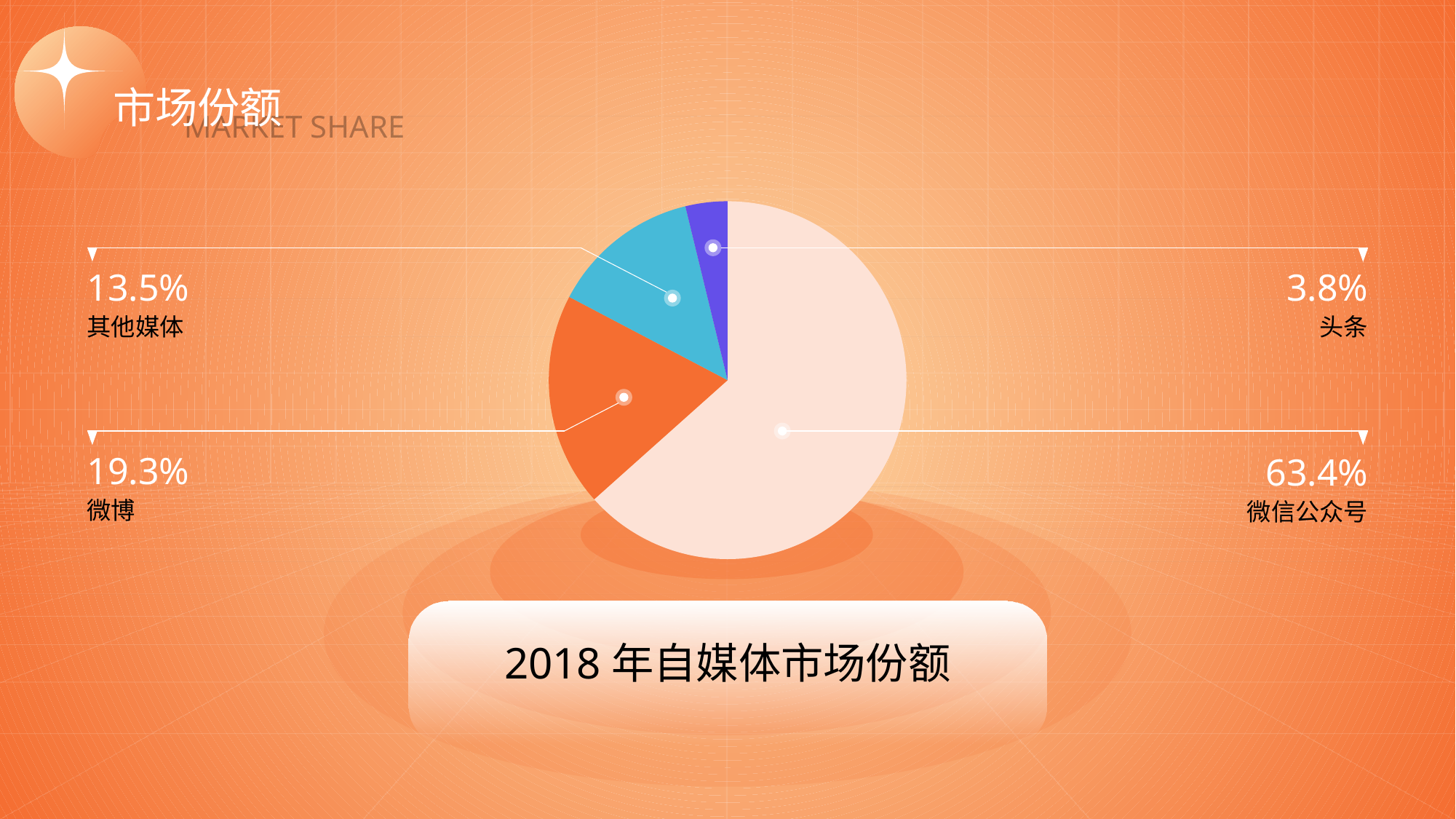
What is the difference between the shares of 微博 and 其他媒体? 5.8% What is the market share of 其他媒体? 13.5% What is the market share of 微信公众号? 63.4% What is the title shown below the pie chart? 2018 年自媒体市场份额 What is the market share of 微博? 19.3% Which category has the largest share of the pie? 微信公众号 What is the difference between the shares of 微信公众号 and 微博? 44.1% How many slices does the pie chart have? 4 What type of chart is shown on the slide? Pie chart Which category has the smallest share of the pie? 头条 What is the market share of 头条? 3.8% Which is larger, the share of 其他媒体 or the share of 头条? 其他媒体